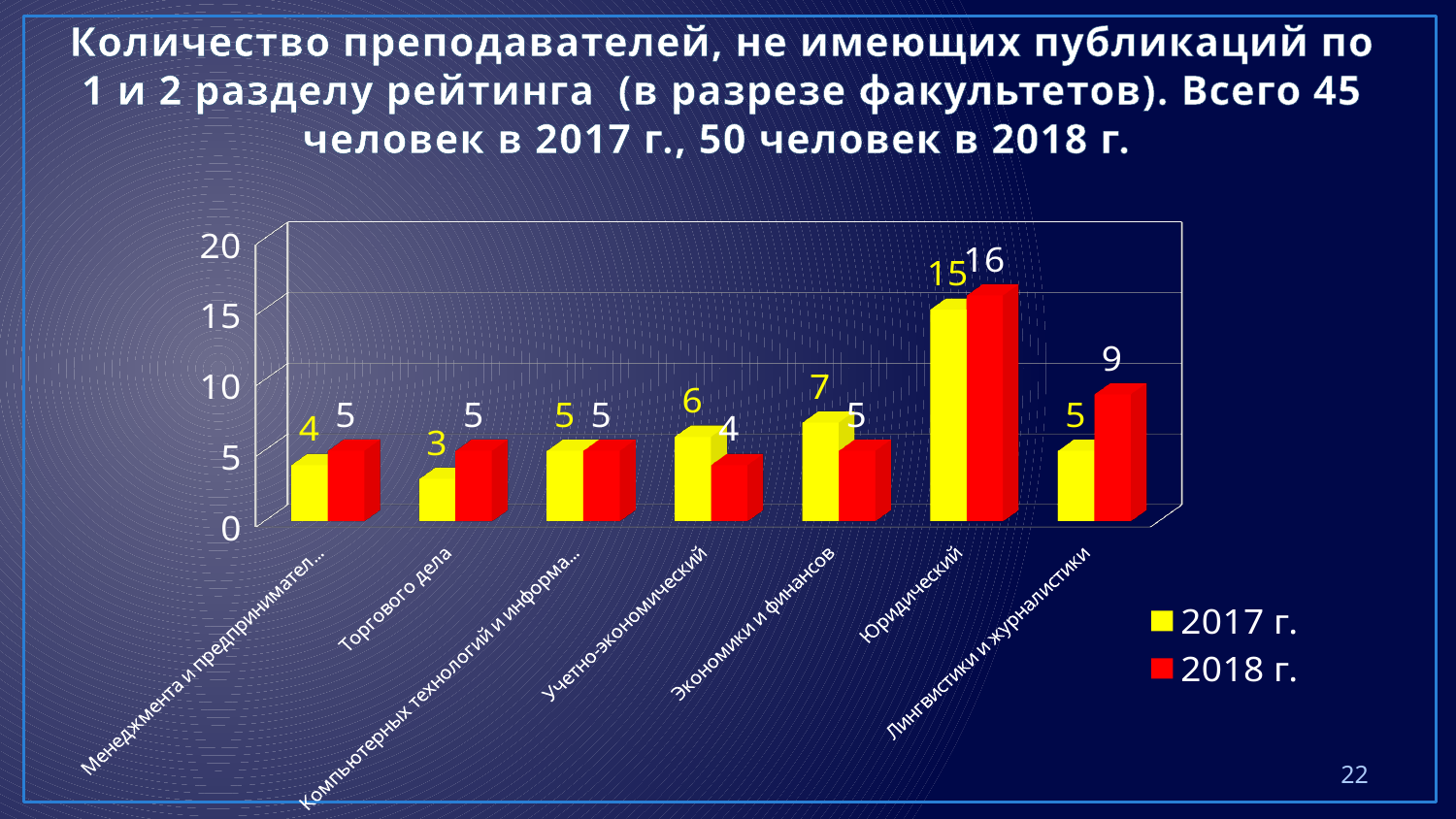
Which colour represents the 2018 г. series in the legend? Red What is the value for Лингвистики и журналистики in 2018 г.? 9 Which faculty has the lowest value in 2017 г.? Торгового дела What type of chart is shown on the slide? Bar chart For Учетно-экономический, which year has the larger value, 2017 г. or 2018 г.? 2017 г. What is the value for Юридический in 2017 г.? 15 How many series does the legend list? 2 What is the value for Юридический in 2018 г.? 16 Which faculty has the highest value in 2018 г.? Юридический How many faculties (categories) are shown on the x axis? 7 What is the difference between the 2018 г. and 2017 г. values for Лингвистики и журналистики? 4 What is the value for Торгового дела in 2017 г.? 3